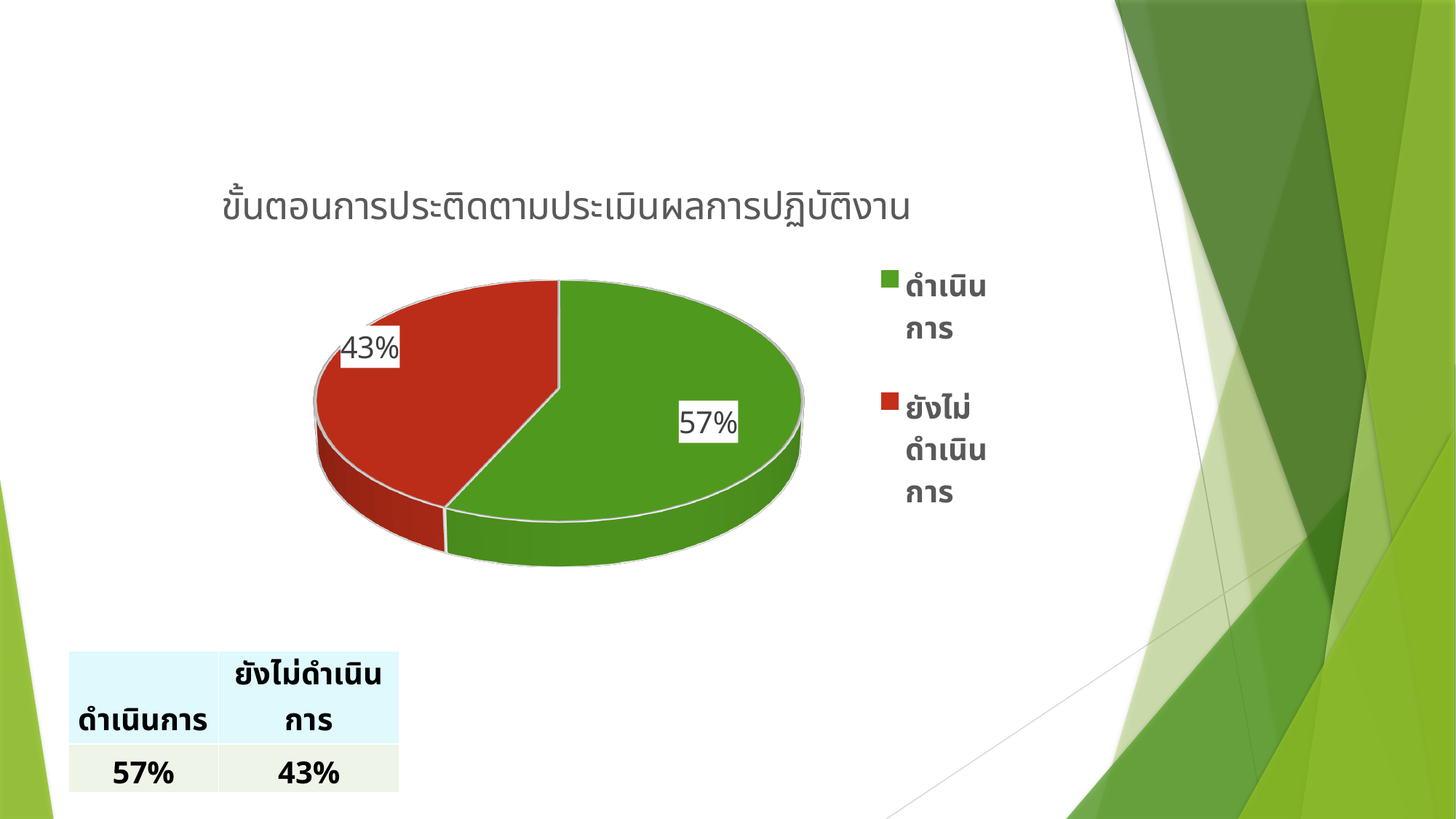
How many entries does the legend list? 2 Which category has the smallest share of the pie? ยังไม่ดำเนินการ Which category has the largest share of the pie? ดำเนินการ What colour is the slice for ยังไม่ดำเนินการ? Red What is the difference between the share for ดำเนินการ and the share for ยังไม่ดำเนินการ? 14% What is the value for ดำเนินการ? 57% How many slices does the pie chart have? 2 What share of the pie does the green slice represent? 57% What is the value for ยังไม่ดำเนินการ? 43% Which is larger, the share for ดำเนินการ or the share for ยังไม่ดำเนินการ? ดำเนินการ What is the title of the chart? ขั้นตอนการประติดตามประเมินผลการปฏิบัติงาน What kind of chart is shown on the slide? Pie chart